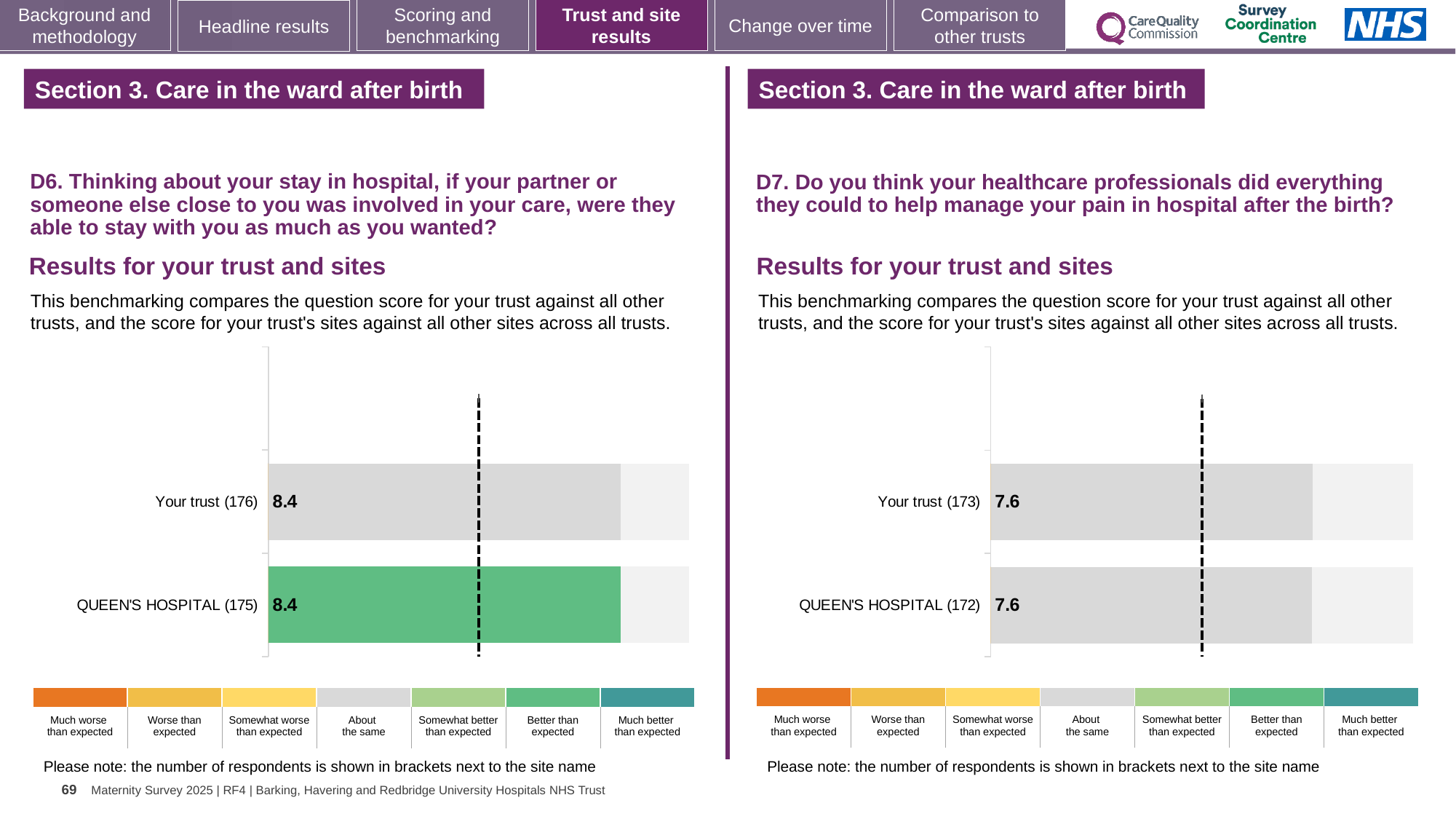
How many bars are plotted in the D7 chart on the right? 2 In the D6 chart on the left, which benchmark category does the green colour of the QUEEN'S HOSPITAL bar correspond to in the legend? Better than expected In the D6 chart on the left, what is the score for QUEEN'S HOSPITAL? 8.4 In the D7 chart on the right, what is the score for Your trust? 7.6 In the D6 chart on the left, what is the difference between the score for Your trust and the score for QUEEN'S HOSPITAL? 0.0 What kind of chart is the D6 chart on the left? Bar chart How many bars are plotted in the D6 chart on the left? 2 In the D6 chart on the left, what is the score for Your trust? 8.4 In the D6 chart on the left, how many respondents are shown in brackets for QUEEN'S HOSPITAL? 175 In the D7 chart on the right, what is the difference between the score for Your trust and the score for QUEEN'S HOSPITAL? 0.0 In the D7 chart on the right, how many respondents are shown in brackets for Your trust? 173 In the D7 chart on the right, what is the score for QUEEN'S HOSPITAL? 7.6